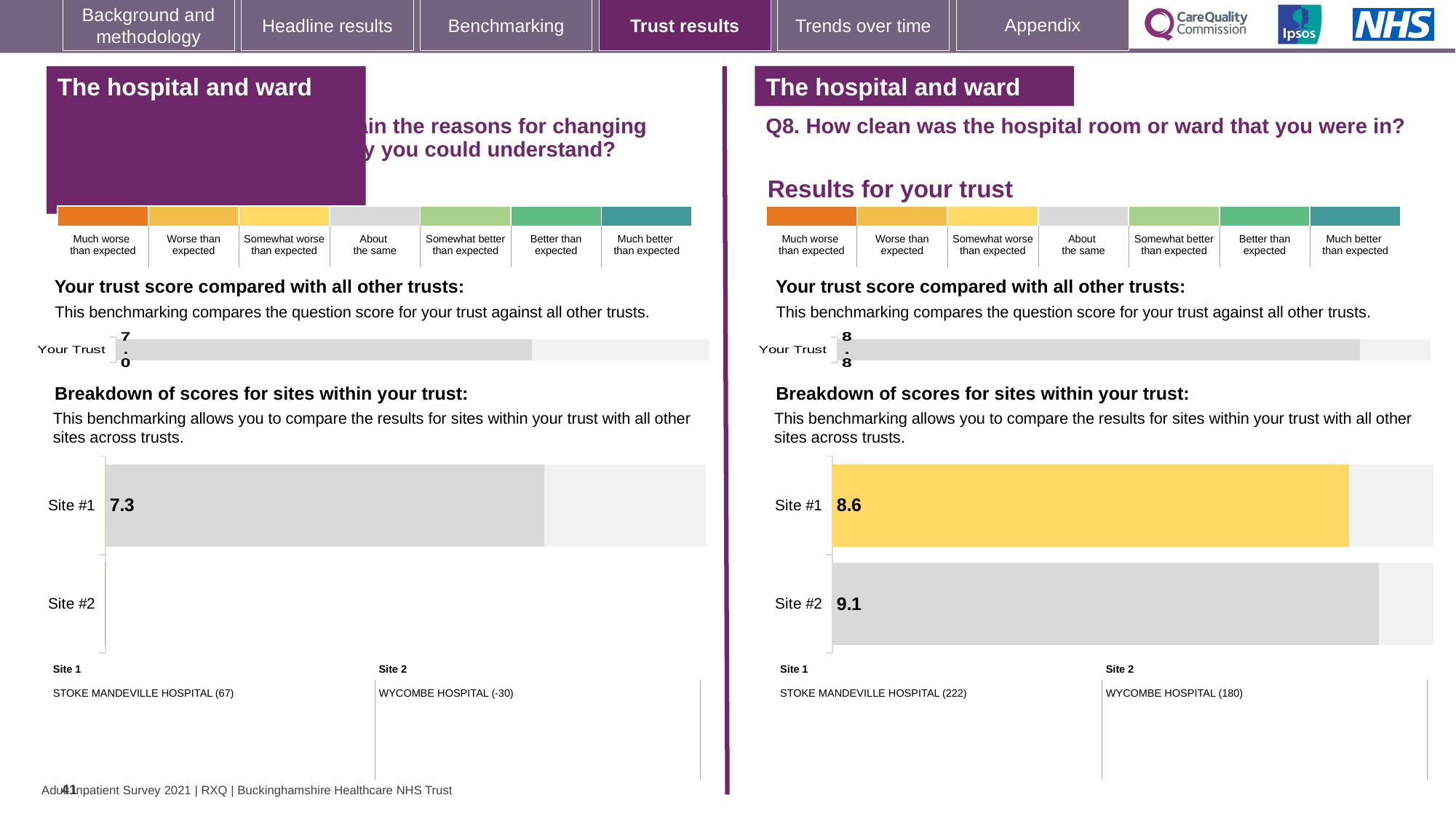
What kind of chart is used to show the breakdown of scores for sites within the trust on the right-hand side? Bar chart On the right-hand chart (Q8), which site has the higher score, Site #1 or Site #2? Site #2 On the left-hand chart, what is the 'Your Trust' score compared with all other trusts? 7.0 On the right-hand chart (Q8), which site's bar is coloured yellow? Site #1 On the left-hand chart, what is the score for Site #1? 7.3 On the left-hand chart, what is the difference between the Site #1 score and the 'Your Trust' score? 0.3 On the right-hand chart (Q8, how clean was the hospital room or ward), what is the score for Site #1? 8.6 On the right-hand chart (Q8), how many sites are shown in the breakdown of scores? 2 On the right-hand chart (Q8, how clean was the hospital room or ward), what is the score for Site #2? 9.1 On the right-hand chart (Q8), what is the 'Your Trust' score compared with all other trusts? 8.8 On the right-hand chart (Q8), which hospital is Site 1? STOKE MANDEVILLE HOSPITAL (222) On the right-hand chart (Q8), what is the difference between the Site #2 score and the Site #1 score? 0.5